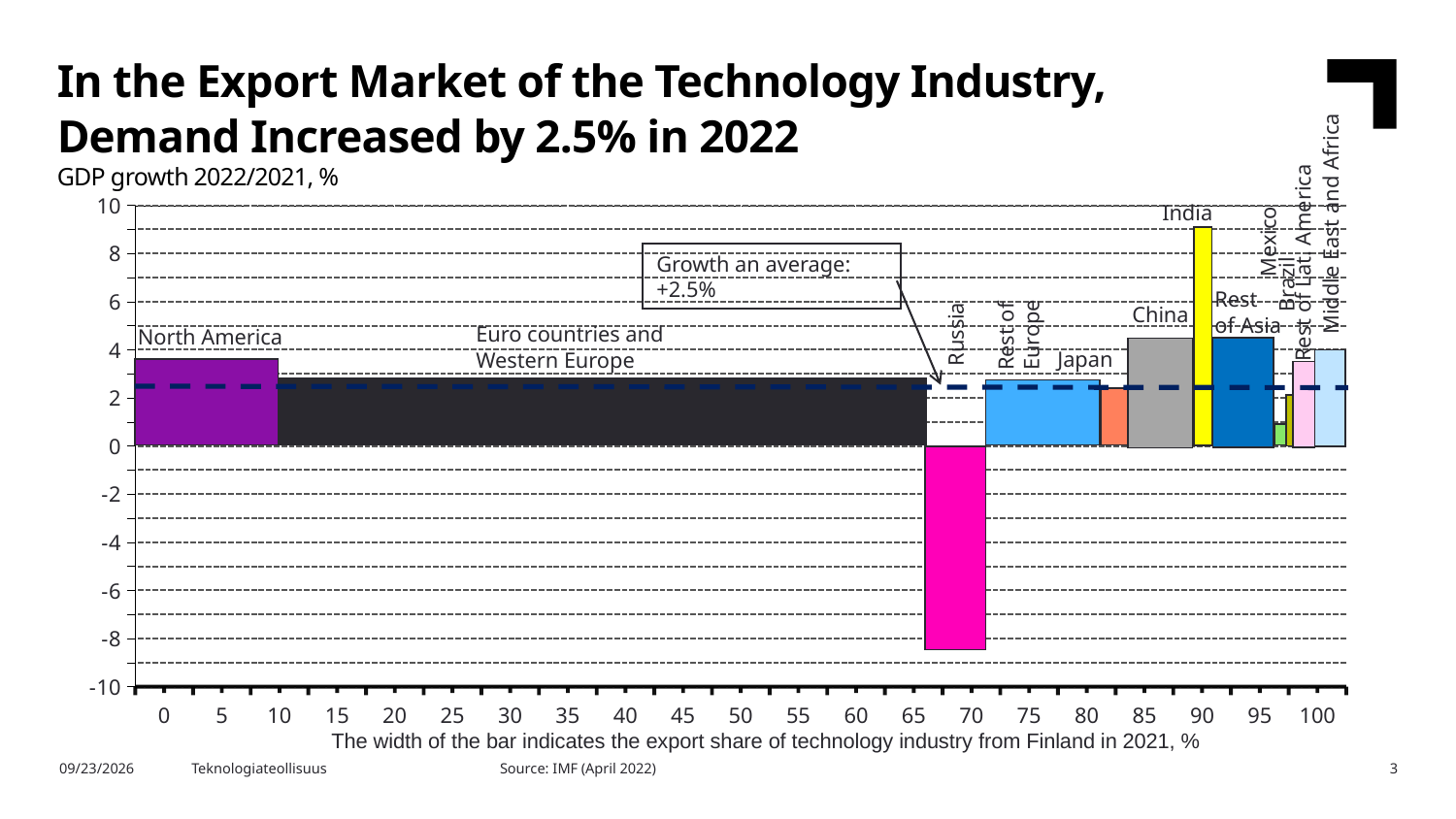
Which region has the lowest GDP growth in the chart? Russia Is the GDP growth value for North America greater or less than 2? greater Is the GDP growth value for Russia greater or less than -5? less How many regions (bars) are plotted in the chart? 12 Is the GDP growth value for India greater or less than 8? greater What is the average growth shown in the annotation box? +2.5% Which region has the highest GDP growth in the chart? India What type of chart is shown on the slide? bar chart Which has higher GDP growth, Russia or Japan? Japan Which has higher GDP growth, India or China? India According to the note below the x axis, what does the width of each bar indicate? The export share of technology industry from Finland in 2021, %